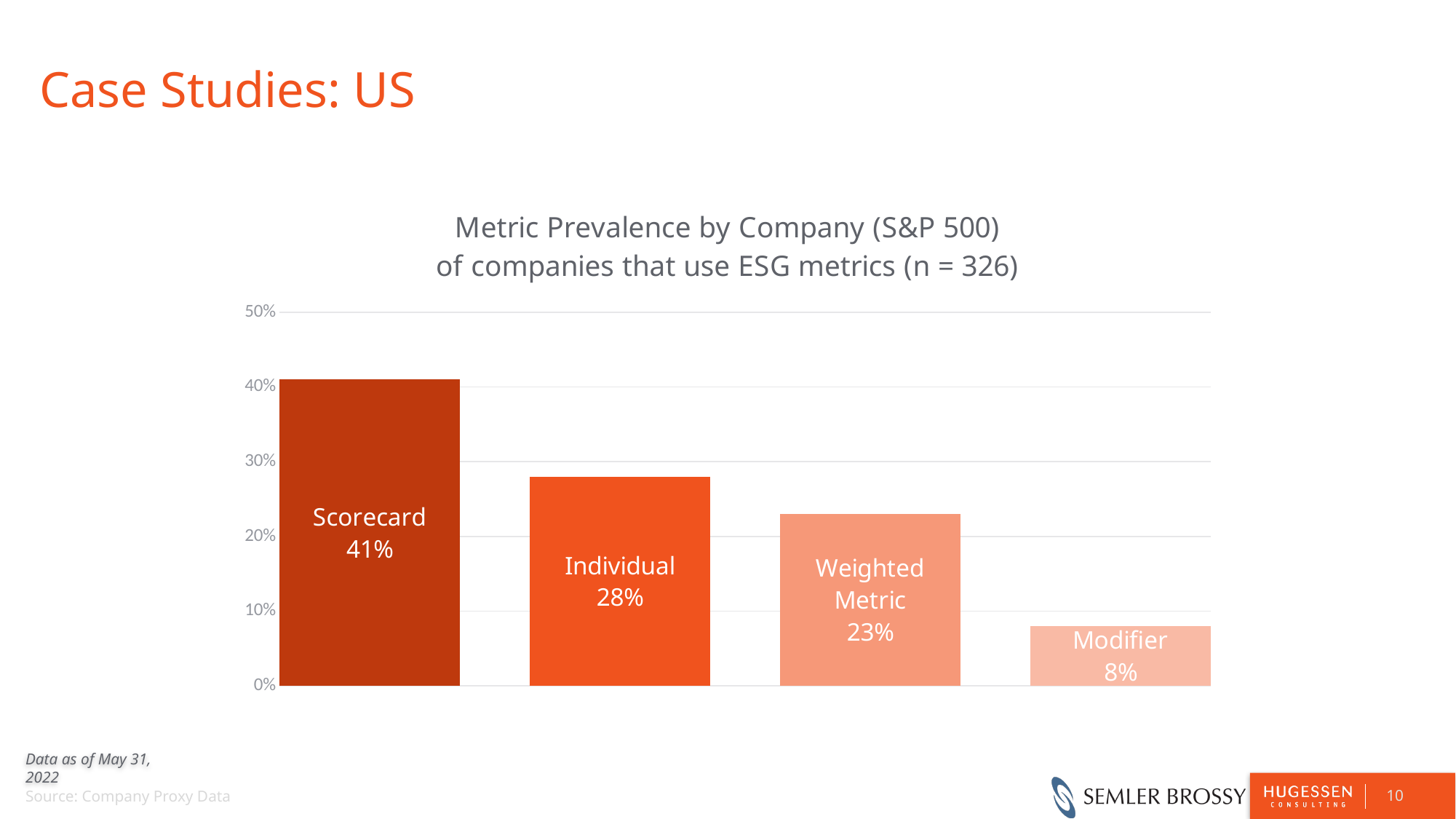
What is the value for Weighted Metric? 23% What is the difference between the values for Scorecard and Individual? 13% Do the values rise or fall from left to right across the categories? Fall How many categories are shown in the chart? 4 What is the difference between the values for Weighted Metric and Modifier? 15% What is the value for Modifier? 8% Which category has the highest value? Scorecard Which is larger, the value for Individual or the value for Weighted Metric? Individual Which category has the lowest value? Modifier Is the value for Individual greater or less than 30%? less What is the value for Scorecard? 41% What kind of chart is shown on the slide? Bar chart